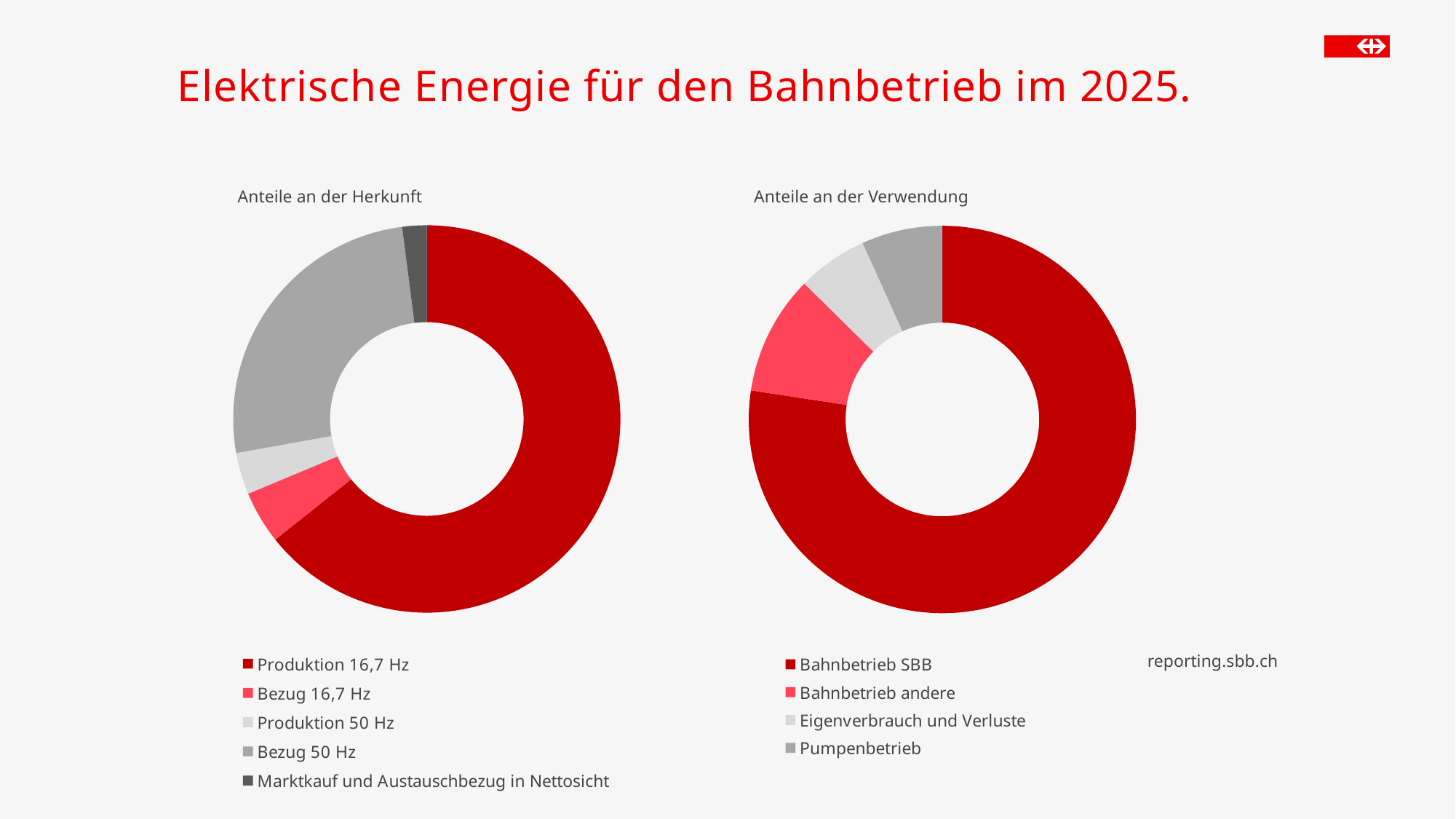
What kind of chart is the "Anteile an der Herkunft" chart? Pie chart (donut) In the "Anteile an der Herkunft" chart, which is larger: Bezug 50 Hz or Bezug 16,7 Hz? Bezug 50 Hz What kind of chart is the "Anteile an der Verwendung" chart? Pie chart (donut) In the "Anteile an der Verwendung" chart, which category has the largest share? Bahnbetrieb SBB What is the title of the chart on the right side of the slide? Anteile an der Verwendung In the "Anteile an der Herkunft" chart, which category has the largest share? Produktion 16,7 Hz In the "Anteile an der Herkunft" chart, which is larger: Produktion 16,7 Hz or Bezug 50 Hz? Produktion 16,7 Hz In the "Anteile an der Herkunft" chart, how many categories does the legend list? 5 In the "Anteile an der Herkunft" chart, which category has the smallest share? Marktkauf und Austauschbezug in Nettosicht In the "Anteile an der Verwendung" chart, how many categories does the legend list? 4 In the "Anteile an der Verwendung" chart, which is larger: Bahnbetrieb andere or Pumpenbetrieb? Bahnbetrieb andere In the "Anteile an der Verwendung" chart, what colour is the Bahnbetrieb SBB slice? Red